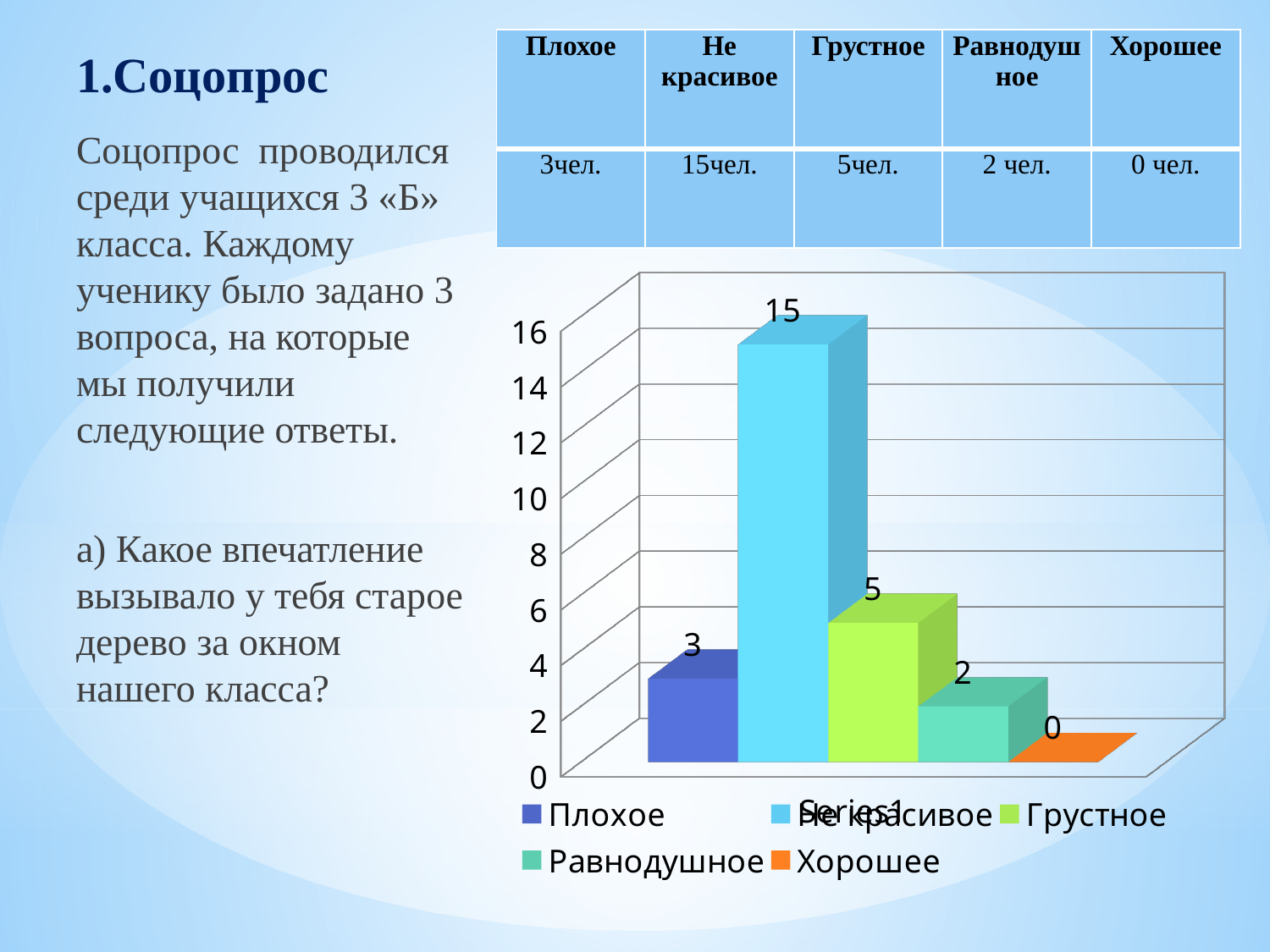
What value is shown for Хорошее in the chart? 0 Is the value for Некрасивое greater or less than 10? greater What value is shown for Некрасивое in the chart? 15 What kind of chart is shown on the slide? bar chart What value is shown for Грустное in the chart? 5 How many bars are plotted in the chart? 5 Which category has the lowest value in the chart? Хорошее How many entries does the chart legend list? 5 Which is larger, the value for Плохое or the value for Равнодушное? Плохое Which category has the highest value in the chart? Некрасивое What value is shown for Плохое in the chart? 3 What is the difference between the values for Некрасивое and Грустное? 10